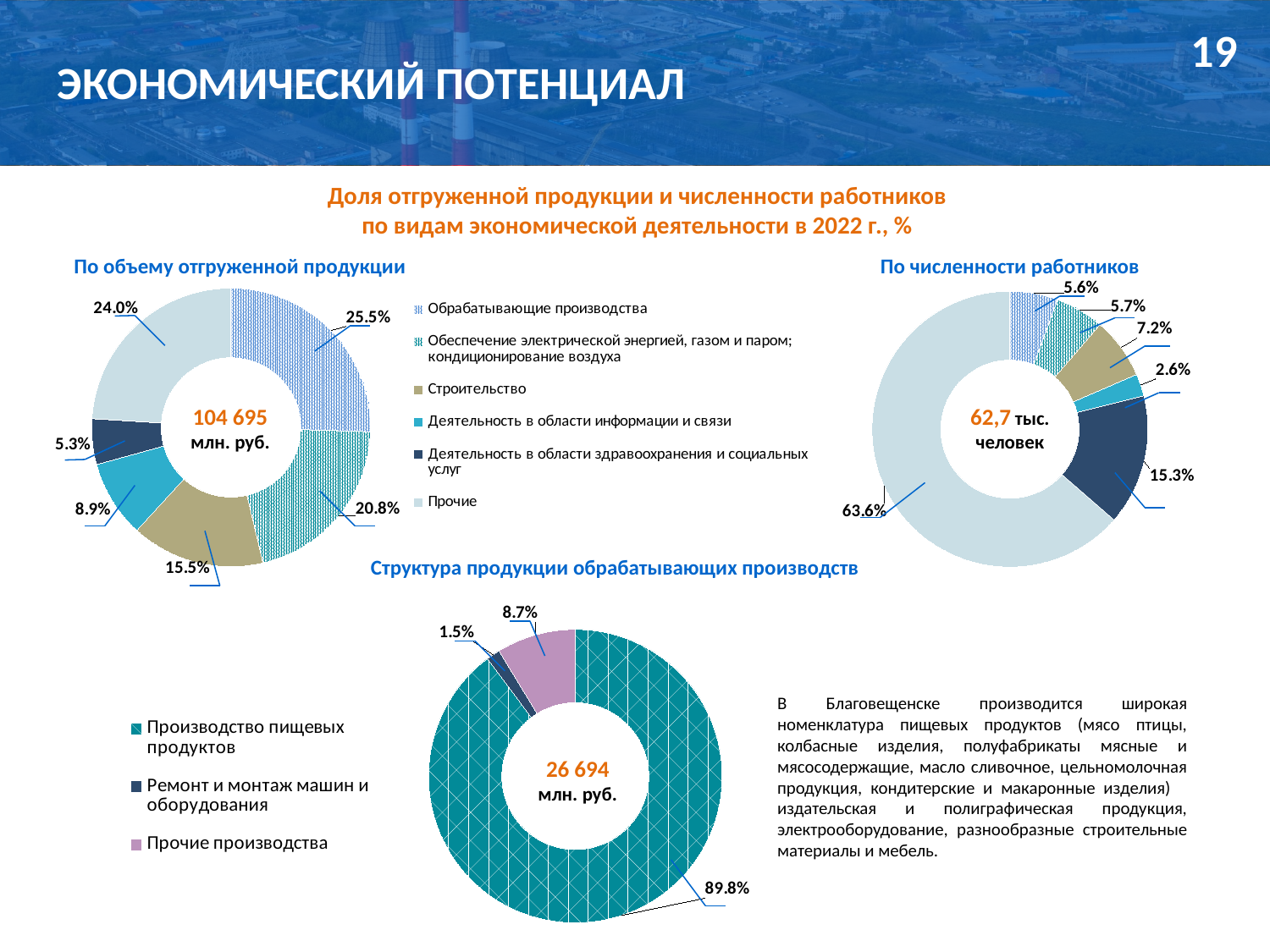
How many categories does the chart 'Структура продукции обрабатывающих производств' show? 3 On the chart 'По численности работников', what is the difference between the shares of 'Строительство' and 'Деятельность в области информации и связи'? 4.6% On the chart 'По объему отгруженной продукции', what share does 'Обрабатывающие производства' have? 25.5% On the chart 'По численности работников', which category has the smallest share? Деятельность в области информации и связи On the chart 'По объему отгруженной продукции', which category has the smallest share? Деятельность в области здравоохранения и социальных услуг On the chart 'По объему отгруженной продукции', what is the total value shown in the centre of the doughnut? 104 695 млн. руб. On the chart 'По численности работников', what share does 'Деятельность в области здравоохранения и социальных услуг' have? 15.3% On the chart 'По объему отгруженной продукции', what share does 'Строительство' have? 15.5% On the chart 'Структура продукции обрабатывающих производств', what share does 'Производство пищевых продуктов' have? 89.8% What type of chart is 'Структура продукции обрабатывающих производств'? Doughnut (pie) chart On the chart 'Структура продукции обрабатывающих производств', what share does 'Ремонт и монтаж машин и оборудования' have? 1.5% On the chart 'По численности работников', what share does 'Прочие' have? 63.6%